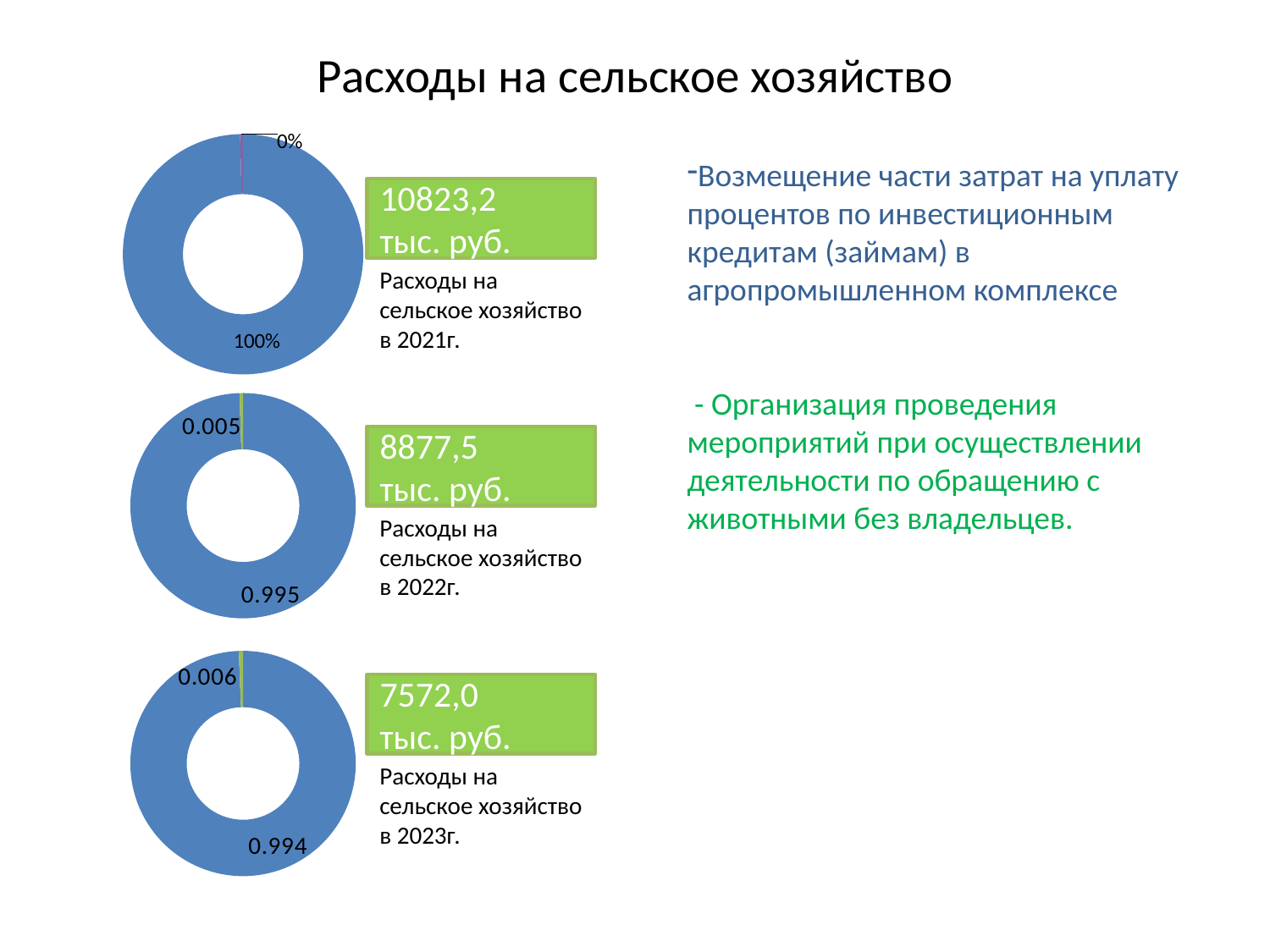
How many doughnut charts are on the slide? 3 In the bottom chart (2023), what value is shown for the large blue segment? 0.994 In the middle chart (2022), what value is shown for the large blue segment? 0.995 How many segments does the bottom chart (2023) have? 2 What total expenditure is shown next to the middle chart for agriculture in 2022? 8877,5 тыс. руб. What kind of chart is used for the 2021 agricultural expenditure (top chart)? doughnut (pie) chart In the bottom chart (2023), which segment is larger, the blue one or the green one? the blue one In the bottom chart (2023), what value is shown for the small green segment? 0.006 In the middle chart (2022), what value is shown for the small green segment? 0.005 In the top chart (2021), what share is shown for the small segment? 0% In the top chart (2021), what share is shown for the large blue segment? 100% Which of the three charts shows the largest value for the small segment? the bottom chart (2023), 0.006